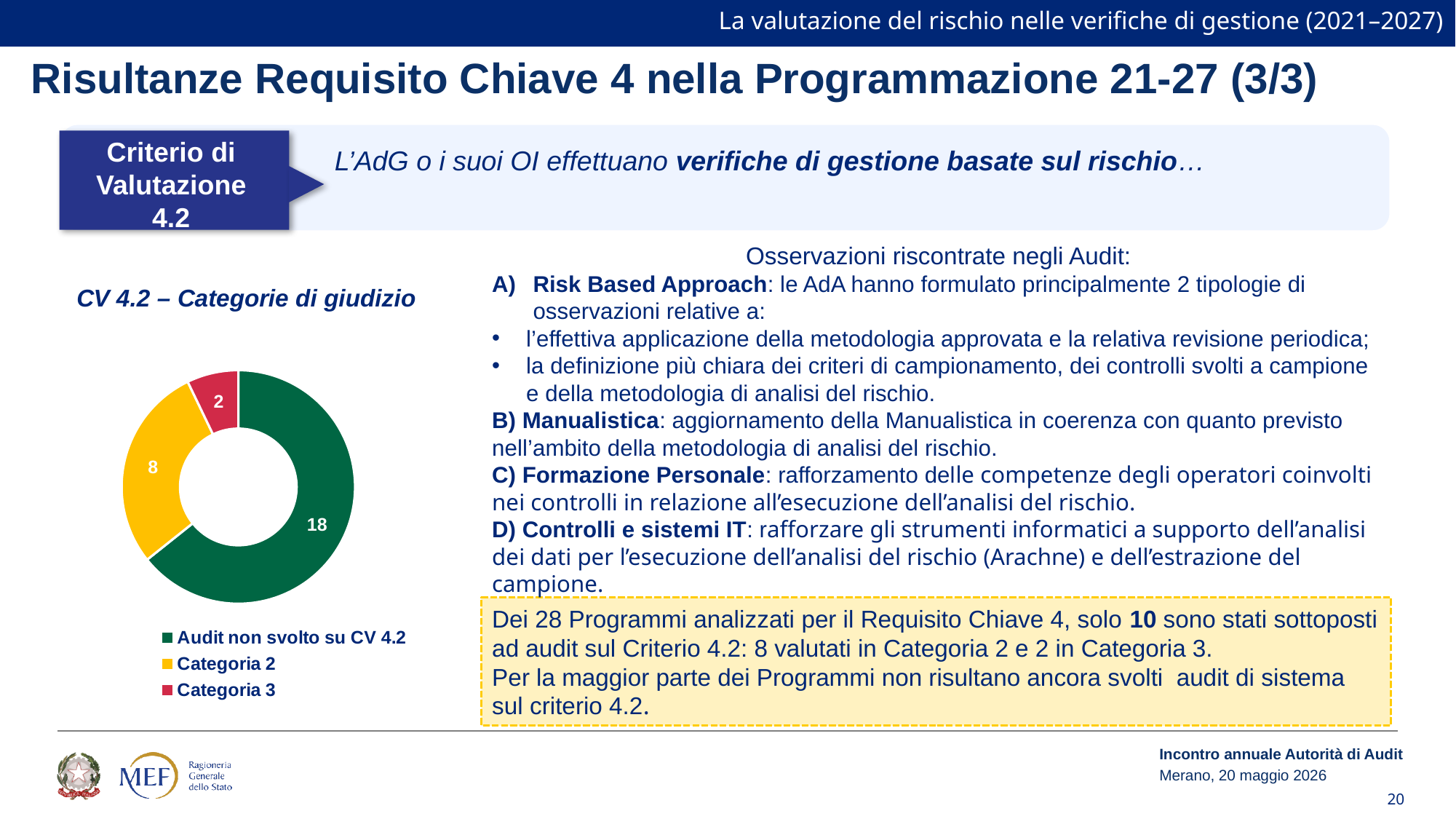
What colour represents 'Categoria 3' in the chart? Red What is the value for 'Categoria 2' in the chart? 8 What is the total of all values shown in the chart? 28 What is the difference between the values for 'Audit non svolto su CV 4.2' and 'Categoria 2'? 10 How many categories does the chart show? 3 What type of chart is shown under 'CV 4.2 – Categorie di giudizio'? Doughnut (pie) chart What is the value for 'Audit non svolto su CV 4.2' in the chart? 18 Which category has the smallest value in the chart? Categoria 3 What is the value for 'Categoria 3' in the chart? 2 Which category has the largest value in the chart? Audit non svolto su CV 4.2 Which is larger: the value for 'Categoria 2' or 'Categoria 3'? Categoria 2